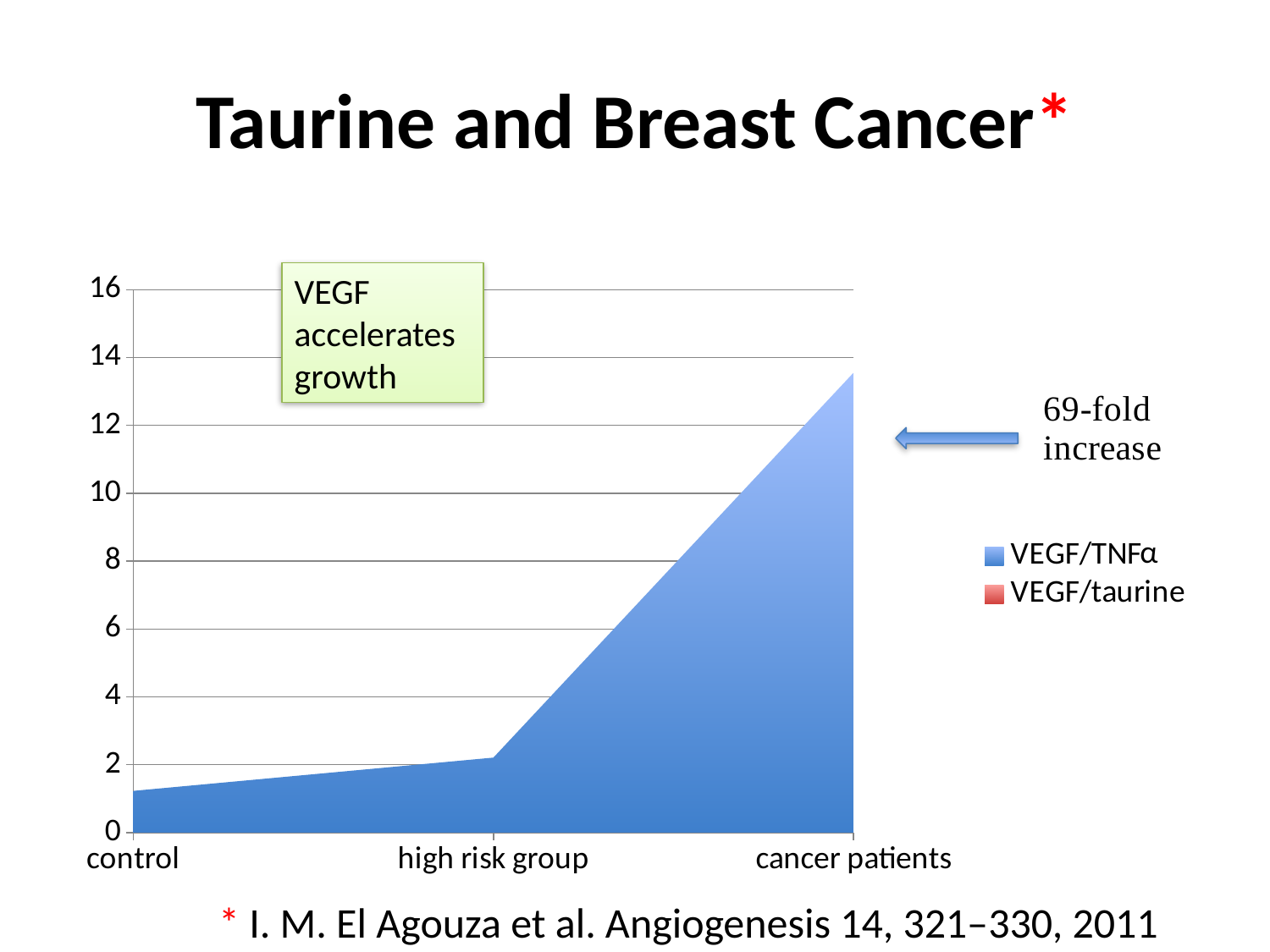
What kind of chart is shown on the slide? area chart Is the VEGF/TNFα value for cancer patients greater or less than 12? greater Do the VEGF/TNFα values rise or fall from control to cancer patients? rise Is the VEGF/TNFα value for control greater or less than 2? less Which category has the lowest VEGF/TNFα value? control What is the title of the slide containing the chart? Taurine and Breast Cancer Which has a larger VEGF/TNFα value, the high risk group or control? high risk group What are the two series named in the chart's legend? VEGF/TNFα and VEGF/taurine Which category has the highest VEGF/TNFα value? cancer patients Is the VEGF/TNFα value for the high risk group greater or less than 4? less How many categories are shown on the x axis of the chart? 3 How many series does the chart's legend list? 2